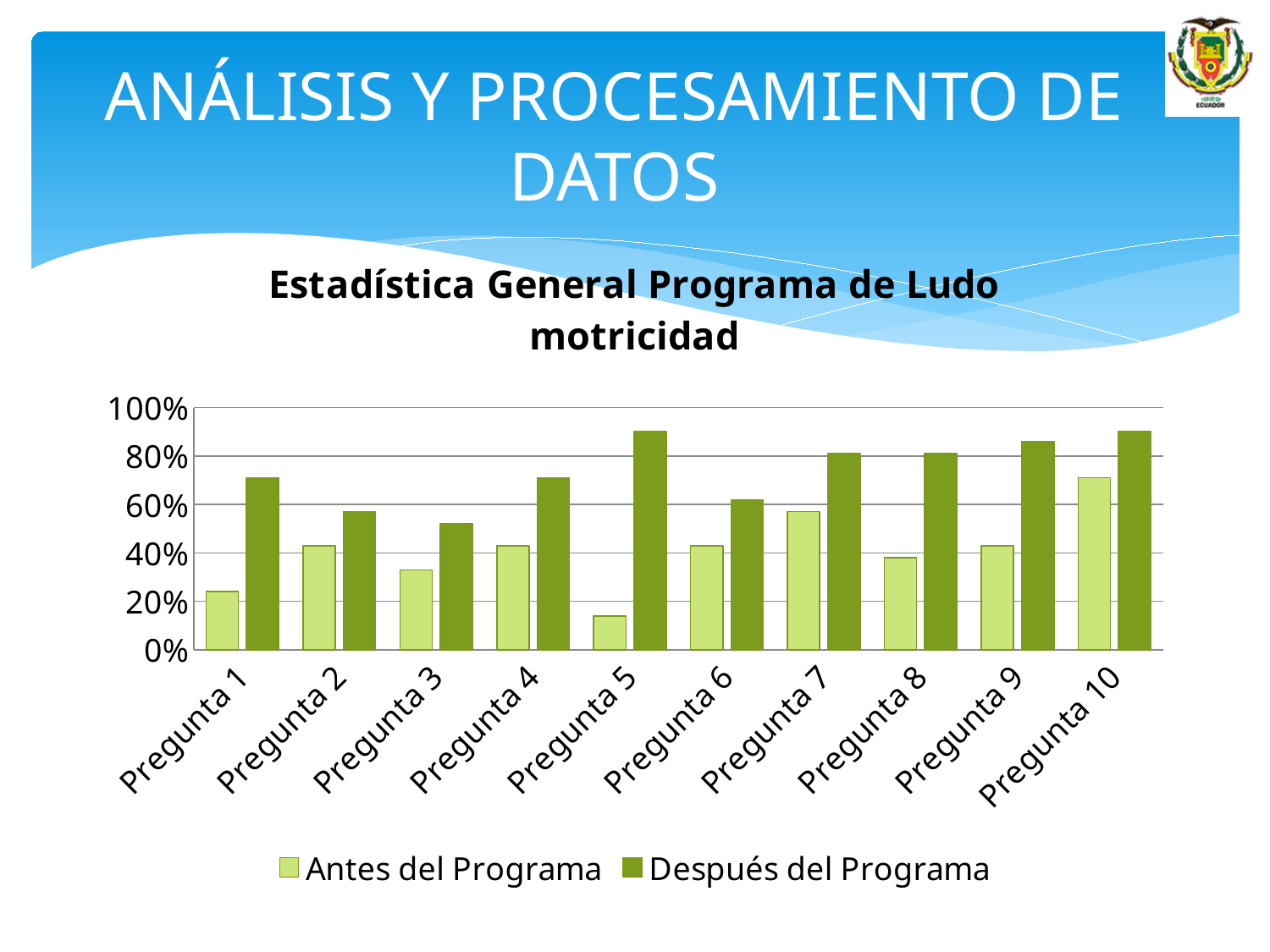
What is the title of the chart? Estadística General Programa de Ludo motricidad Is the Antes del Programa value for Pregunta 10 greater or less than 60%? greater For Pregunta 7, which is larger: Antes del Programa or Después del Programa? Después del Programa Is the Después del Programa value for Pregunta 3 greater or less than 60%? less Is the Antes del Programa value for Pregunta 1 greater or less than 40%? less Which pregunta has the highest value for Antes del Programa? Pregunta 10 Which is larger: the Después del Programa value for Pregunta 9 or for Pregunta 2? Pregunta 9 How many series does the legend list? 2 Which pregunta has the lowest value for Antes del Programa? Pregunta 5 What kind of chart is shown on the slide? bar chart How many categories (preguntas) are shown on the x axis? 10